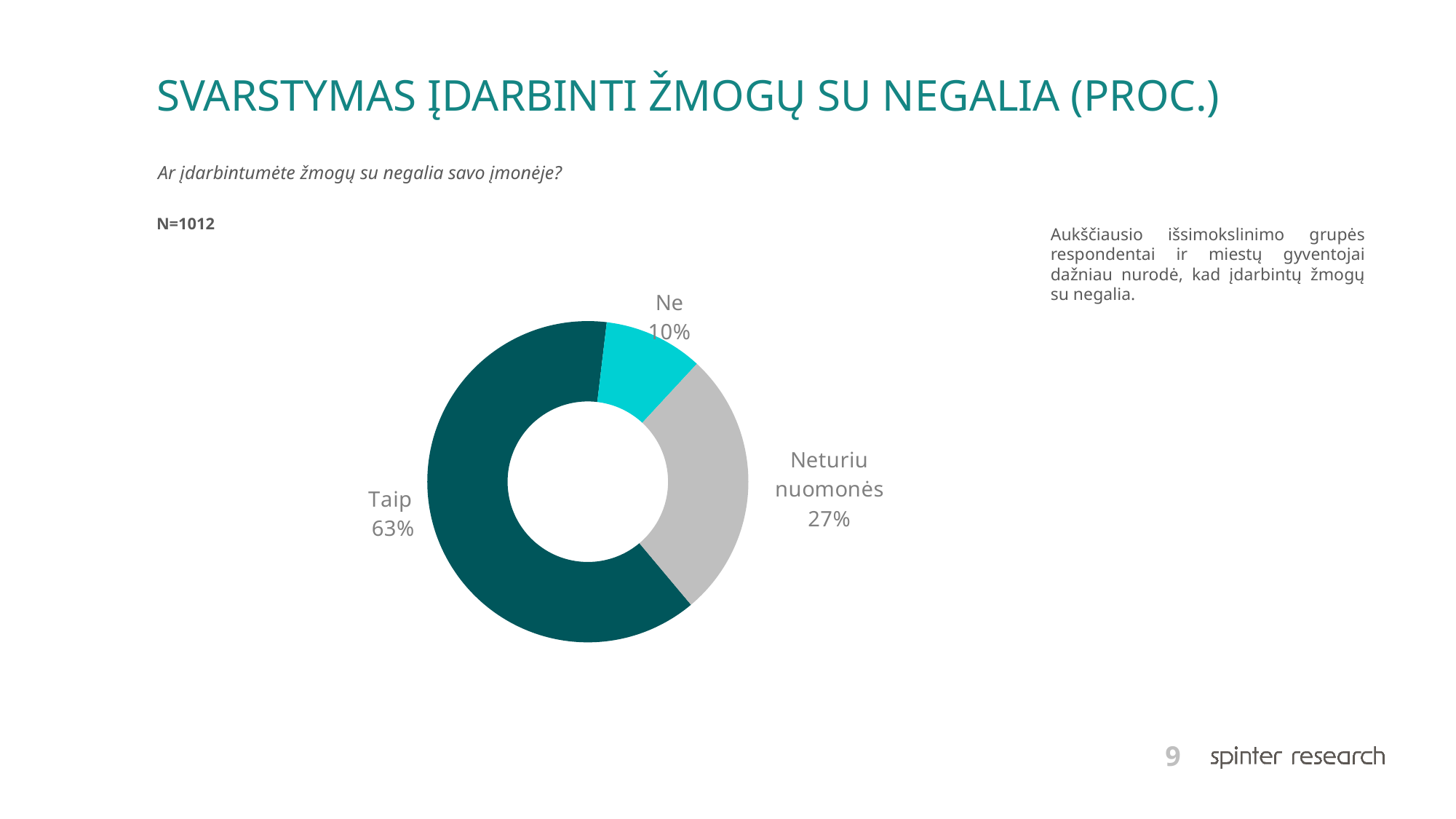
What percentage of respondents answered "Taip"? 63% How many categories are shown in the chart? 3 Which response has the smallest share of the chart? Ne What is the sample size (N) stated on the slide? N=1012 What percentage of respondents answered "Ne"? 10% Which response has the largest share of the chart? Taip What is the difference in percentage points between "Neturiu nuomonės" and "Ne"? 17 What percentage of respondents answered "Neturiu nuomonės"? 27% What kind of chart is shown on the slide? Doughnut (pie) chart Which is larger, the share for "Ne" or the share for "Neturiu nuomonės"? Neturiu nuomonės What colour is the "Ne" slice of the chart? Light cyan/turquoise What is the difference in percentage points between "Taip" and "Neturiu nuomonės"? 36